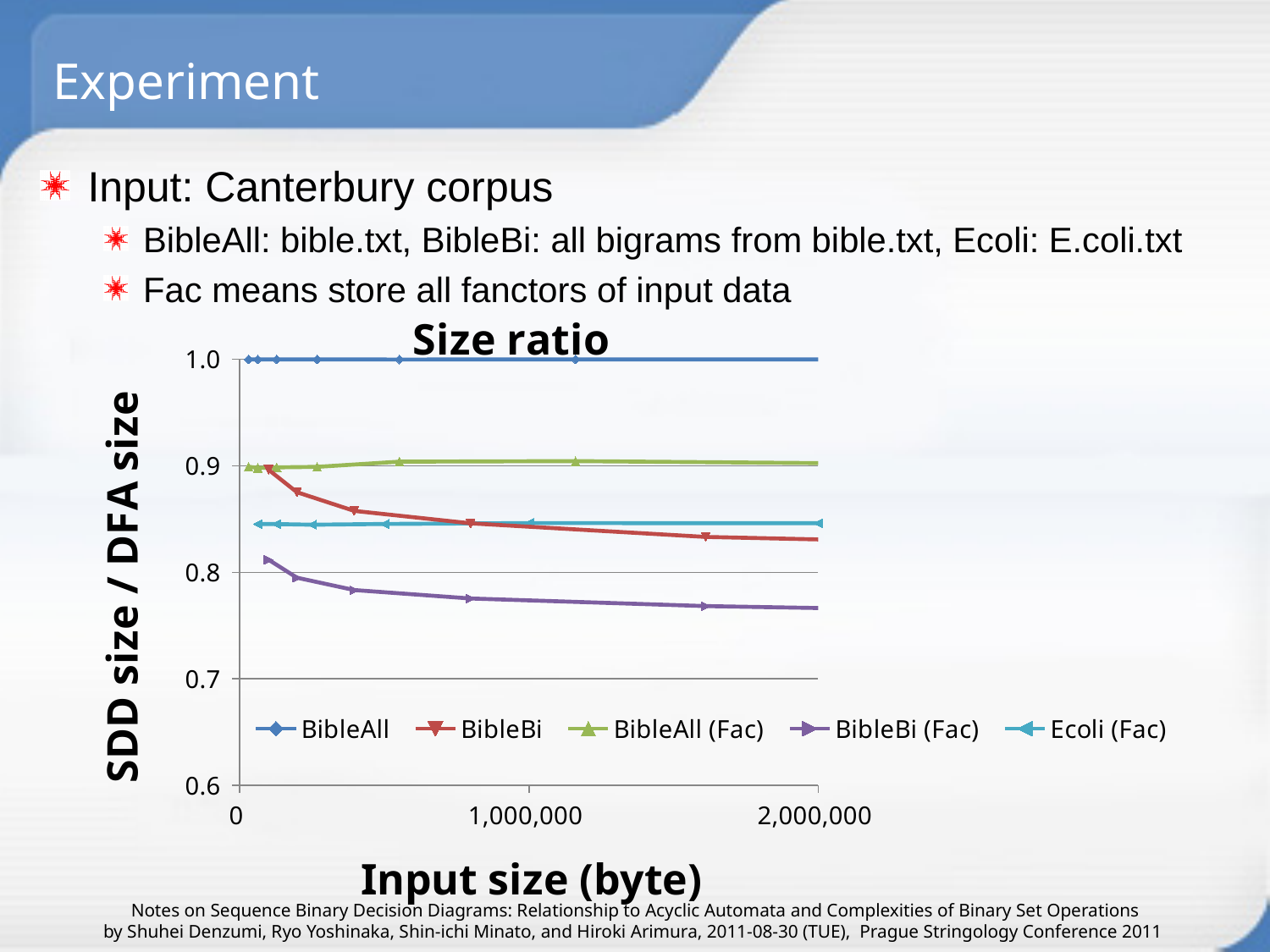
What is the label of the vertical axis of the chart? SDD size / DFA size Does the BibleBi series rise or fall as input size increases? fall Which series has the lowest values across the whole chart? BibleBi (Fac) Which series has larger values, BibleAll (Fac) or BibleBi (Fac)? BibleAll (Fac) What kind of chart is shown on the slide? line chart What is the title of the chart? Size ratio Which series has the highest values across the whole chart? BibleAll At the largest input size, is the value for BibleBi (Fac) greater or less than 0.8? less Is the value for Ecoli (Fac) greater or less than 0.9? less How many series does the legend of the chart list? 5 Does the BibleBi (Fac) series rise or fall as input size increases? fall What value does the BibleAll series stay at across all input sizes? 1.0